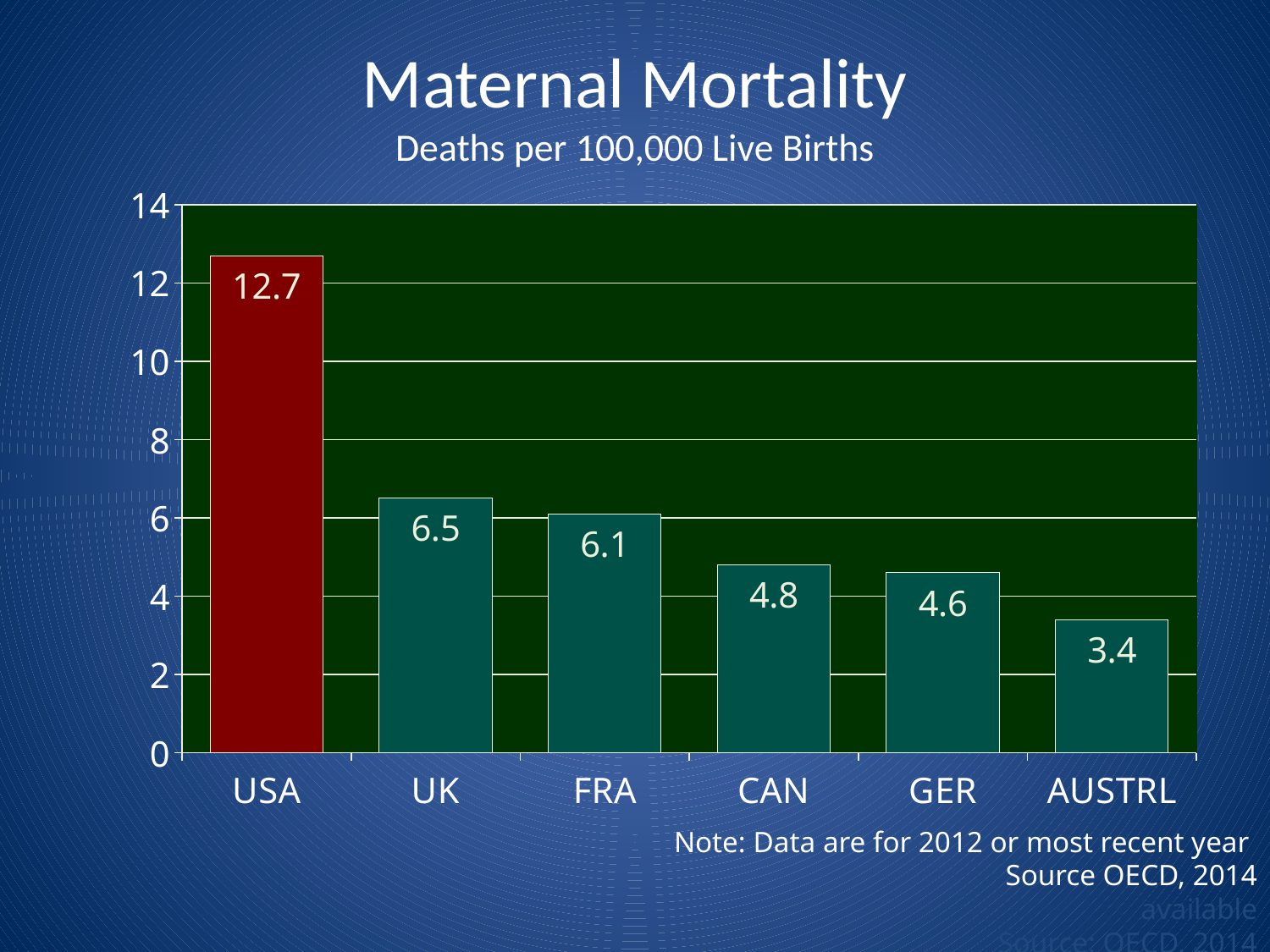
Which has a higher value, UK or FRA? UK Which country has the highest maternal mortality rate on the chart? USA What kind of chart is shown on the slide? bar chart How many countries are shown on the chart? 6 What is the value shown for Germany (GER)? 4.6 Is the value for CAN greater or less than 6? less What is the maternal mortality value for the USA? 12.7 What is the difference between the FRA value and the CAN value? 1.3 What is the difference between the USA value and the UK value? 6.2 Which country has the lowest maternal mortality rate on the chart? AUSTRL Do the values rise or fall moving from left to right across the x axis? fall What is the value shown for AUSTRL? 3.4